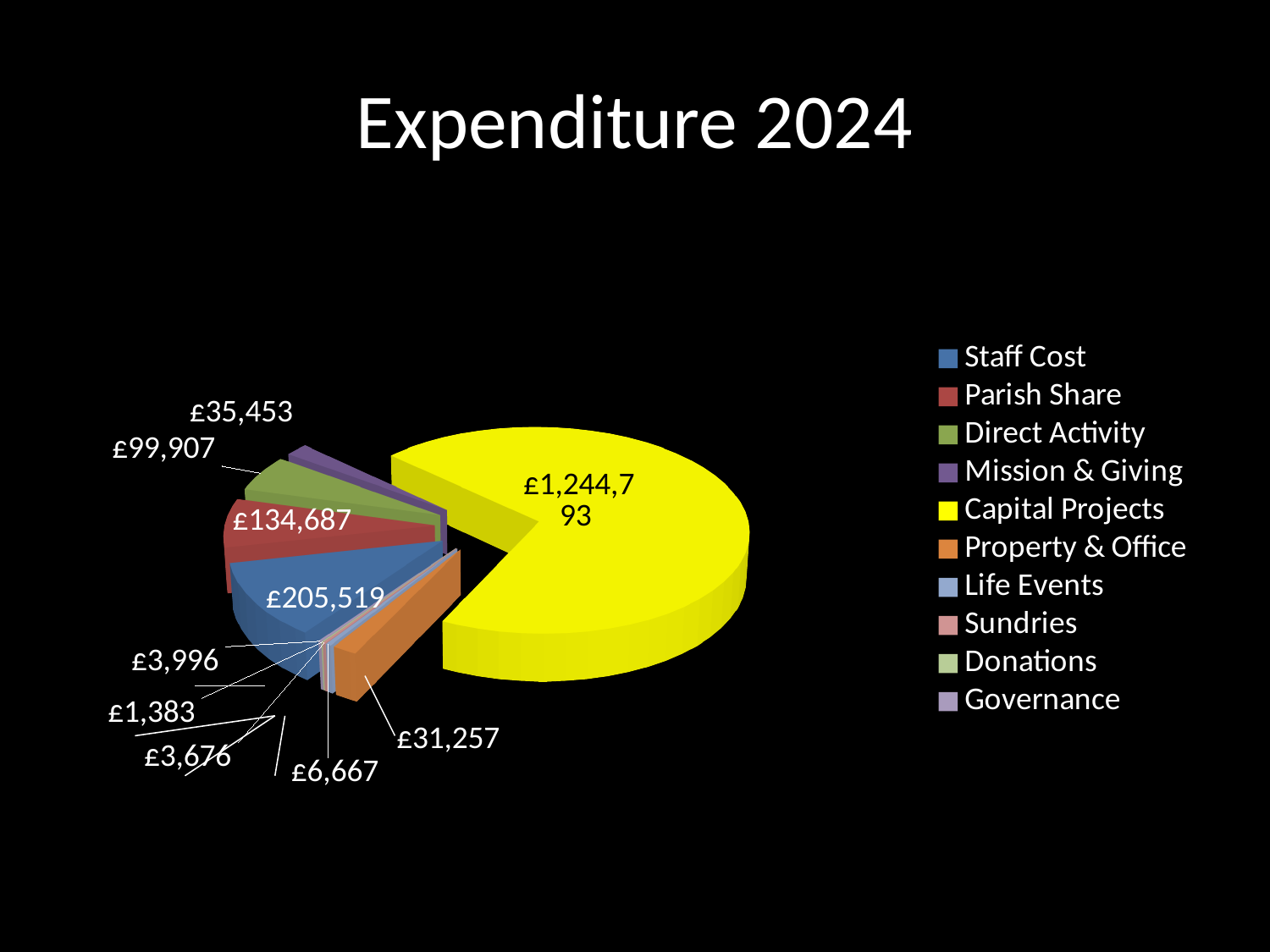
Which is larger, Staff Cost or Parish Share? Staff Cost What is the value for Staff Cost? £205,519 Which category has the largest slice of the pie? Capital Projects What kind of chart is shown on the slide? Pie chart What is the value for Parish Share? £134,687 How many categories does the legend list? 10 What is the value for Property & Office? £31,257 What is the title of the chart? Expenditure 2024 What colour is the Capital Projects slice? Yellow What is the value for Capital Projects? £1,244,793 What is the difference between Staff Cost and Parish Share? £70,832 What is the value for Direct Activity? £99,907